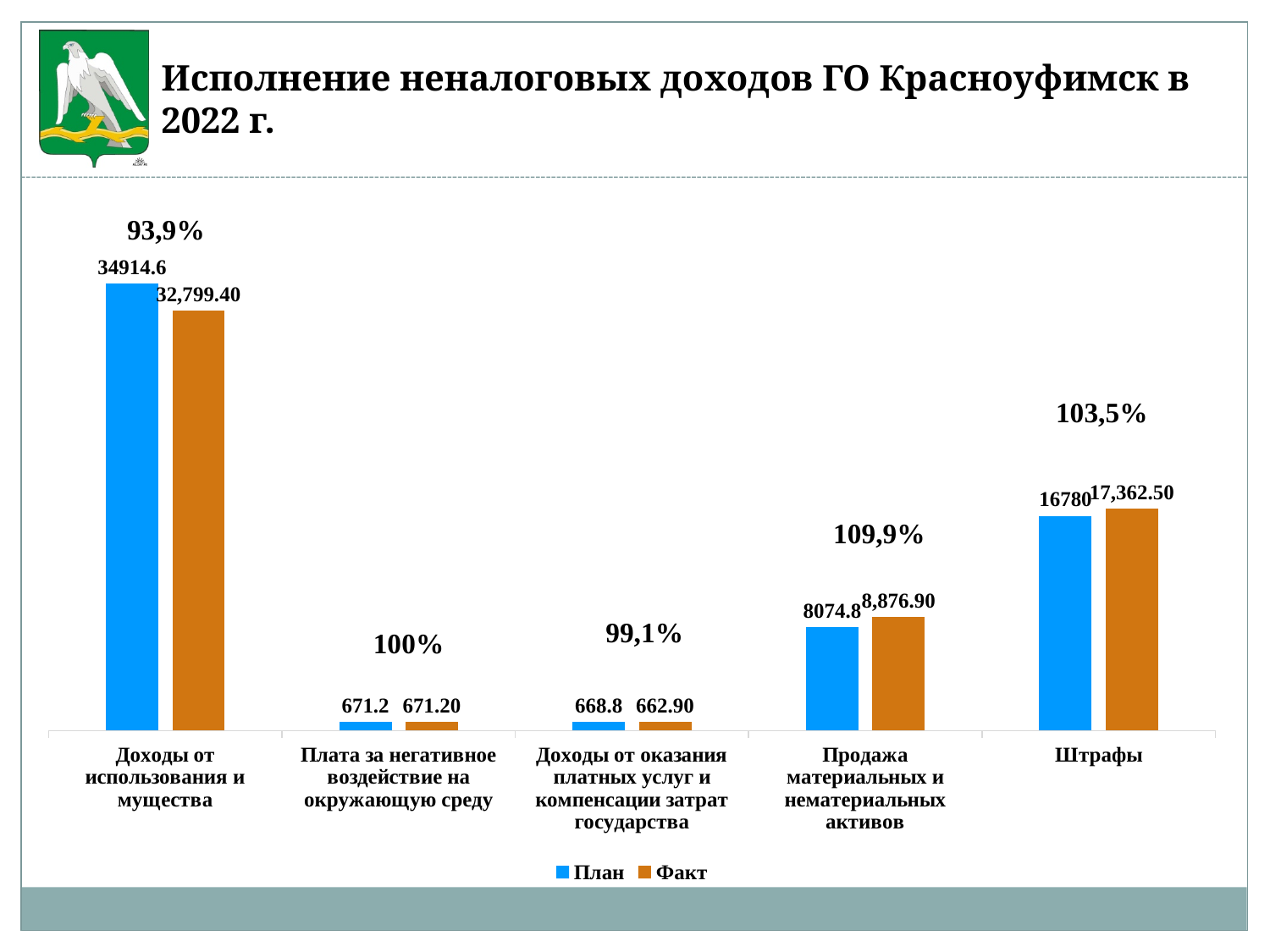
What percentage is shown above the bars for Продажа материальных и нематериальных активов? 109,9% What kind of chart is shown on the slide? Bar chart What is the План value for Штрафы? 16780 What is the Факт value for Продажа материальных и нематериальных активов? 8,876.90 Which category has the lowest Факт value? Доходы от оказания платных услуг и компенсации затрат государства Which category has the highest План value? Доходы от использования имущества What is the План value for Доходы от оказания платных услуг и компенсации затрат государства? 668.8 What is the Факт value for Доходы от использования имущества? 32,799.40 What is the difference between the Факт and План values for Штрафы? 582.50 How many categories are shown on the x axis? 5 How many series does the legend list? 2 For Доходы от использования имущества, which is larger: План or Факт? План